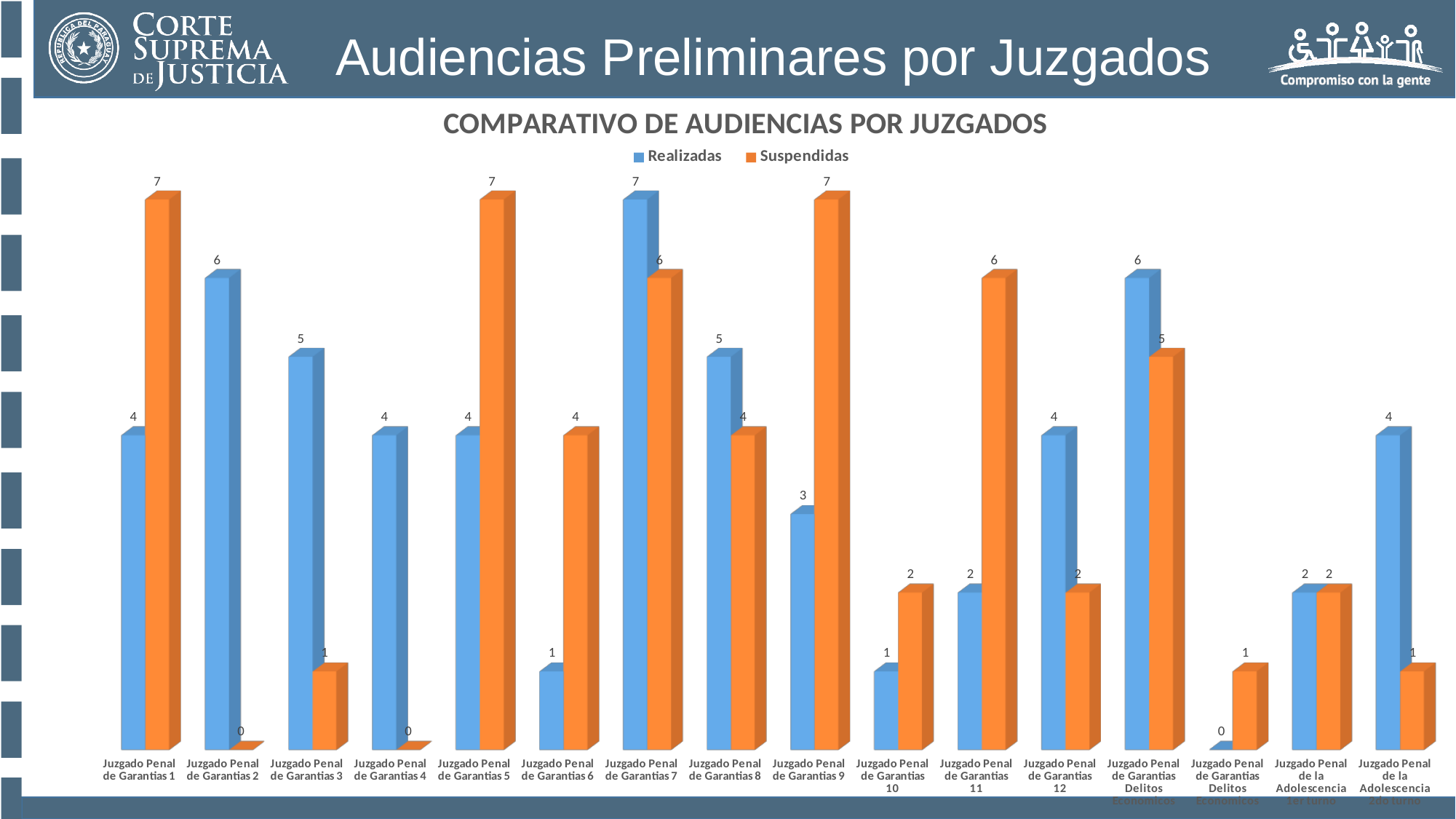
What kind of chart is shown on the slide? Bar chart For Juzgado Penal de Garantias 9, how much larger is the Suspendidas value than the Realizadas value? 4 What is the Suspendidas value for Juzgado Penal de Garantias 11? 6 What is the Realizadas value for Juzgado Penal de Garantias 6? 1 What is the combined total of Realizadas and Suspendidas for Juzgado Penal de Garantias 1? 11 How many series does the legend list? 2 For Juzgado Penal de Garantias 8, which is larger: Realizadas or Suspendidas? Realizadas What are the two series named in the legend? Realizadas and Suspendidas What is the Suspendidas value for Juzgado Penal de Garantias 2? 0 How many juzgados (categories) are shown on the x axis? 16 What is the Realizadas value for Juzgado Penal de Garantias 3? 5 Which juzgado has the highest Realizadas value? Juzgado Penal de Garantias 7